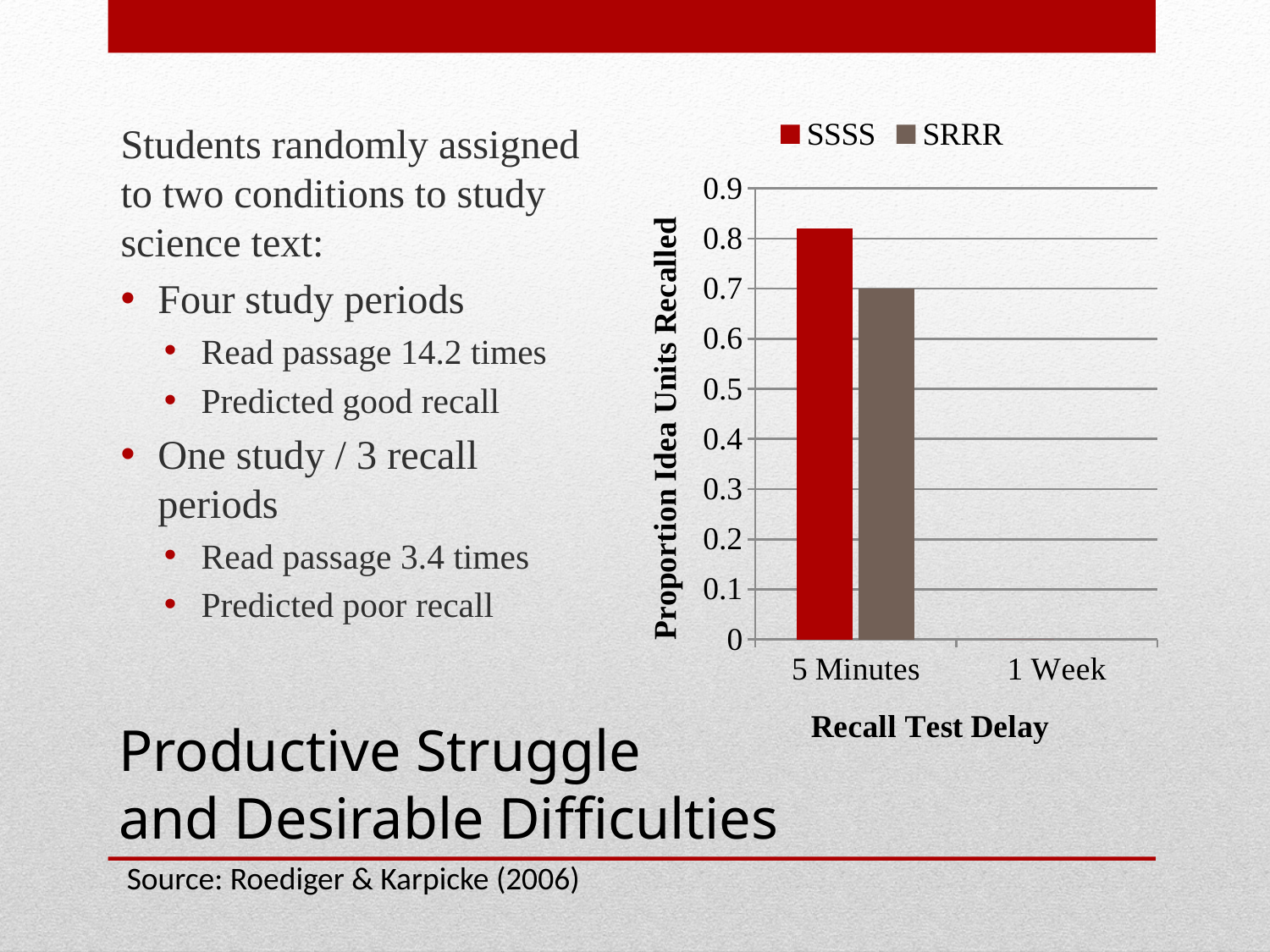
What is the title of the chart's vertical axis? Proportion Idea Units Recalled What are the two series named in the chart legend? SSSS and SRRR What is the value for SRRR at the 5 Minutes recall test delay? 0.7 How many recall test delay categories are labelled on the x axis? 2 What kind of chart is shown on the slide? bar chart Which series has the highest bar in the chart? SSSS Is the value for SSSS at 5 Minutes greater or less than 0.5? greater At the 5 Minutes delay, which series has the larger value, SSSS or SRRR? SSSS Is the value for SSSS at 5 Minutes greater or less than 0.8? greater Is the value for SRRR at 5 Minutes greater or less than 0.8? less How many series does the chart legend list? 2